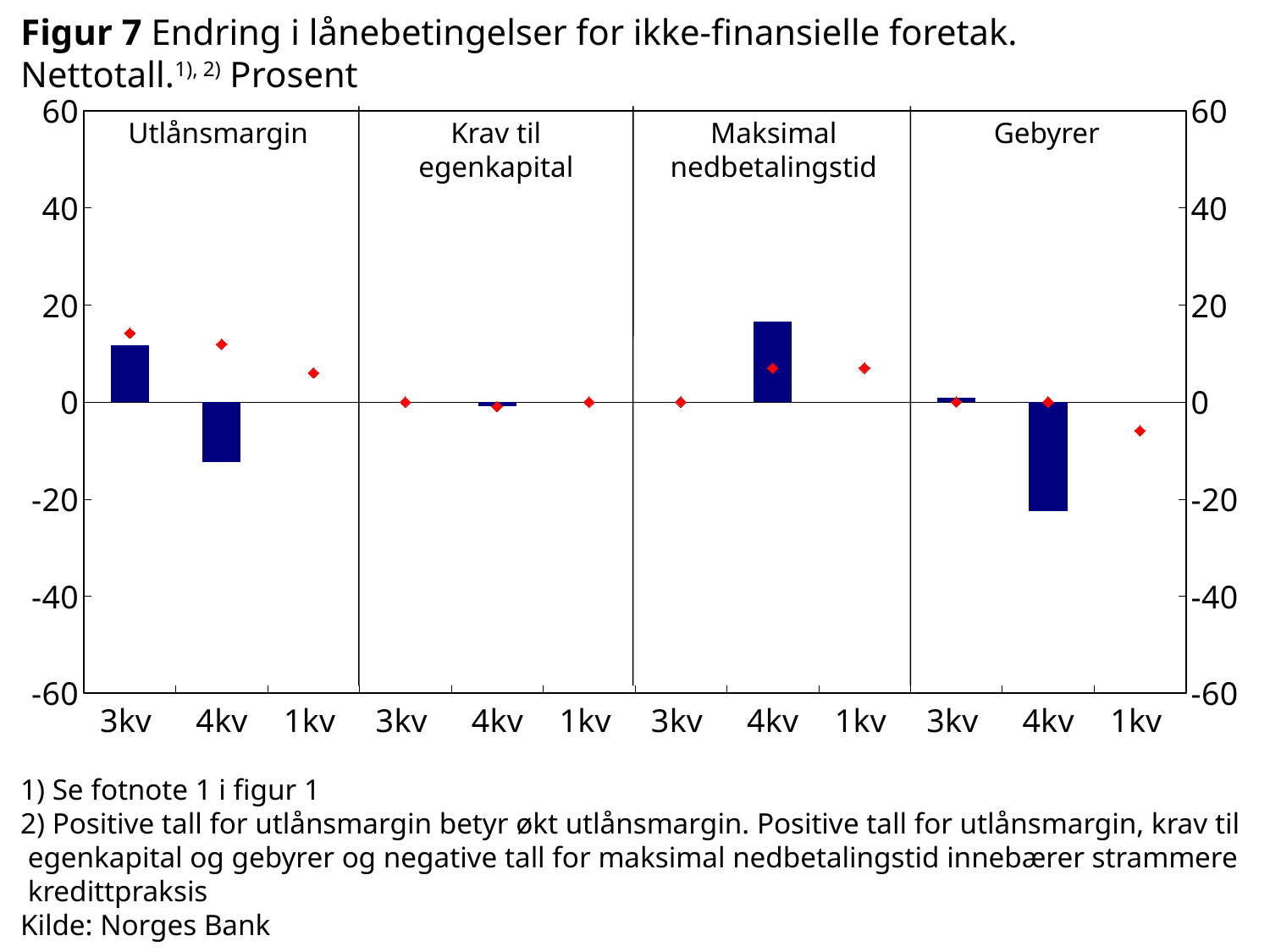
Is the bar for 4kv in the Gebyrer panel greater or less than -20? less How many panels (loan condition categories) does the chart have? 4 Which panel contains the tallest positive bar? Maksimal nedbetalingstid Is the bar for 4kv in the Utlånsmargin panel greater or less than 0? less Which panel contains the lowest (most negative) bar? Gebyrer What are the four panel headings in the chart? Utlånsmargin, Krav til egenkapital, Maksimal nedbetalingstid, Gebyrer Which is larger, the 3kv bar in the Utlånsmargin panel or the 3kv bar in the Gebyrer panel? Utlånsmargin 3kv What is the maximum value shown on the vertical axis? 60 In the Utlånsmargin panel, do the red diamond markers rise or fall from 3kv to 1kv? fall Is the bar for 4kv in the Maksimal nedbetalingstid panel greater or less than 20? less What kind of chart is shown in Figur 7? combination bar and line chart (bars with red diamond markers)